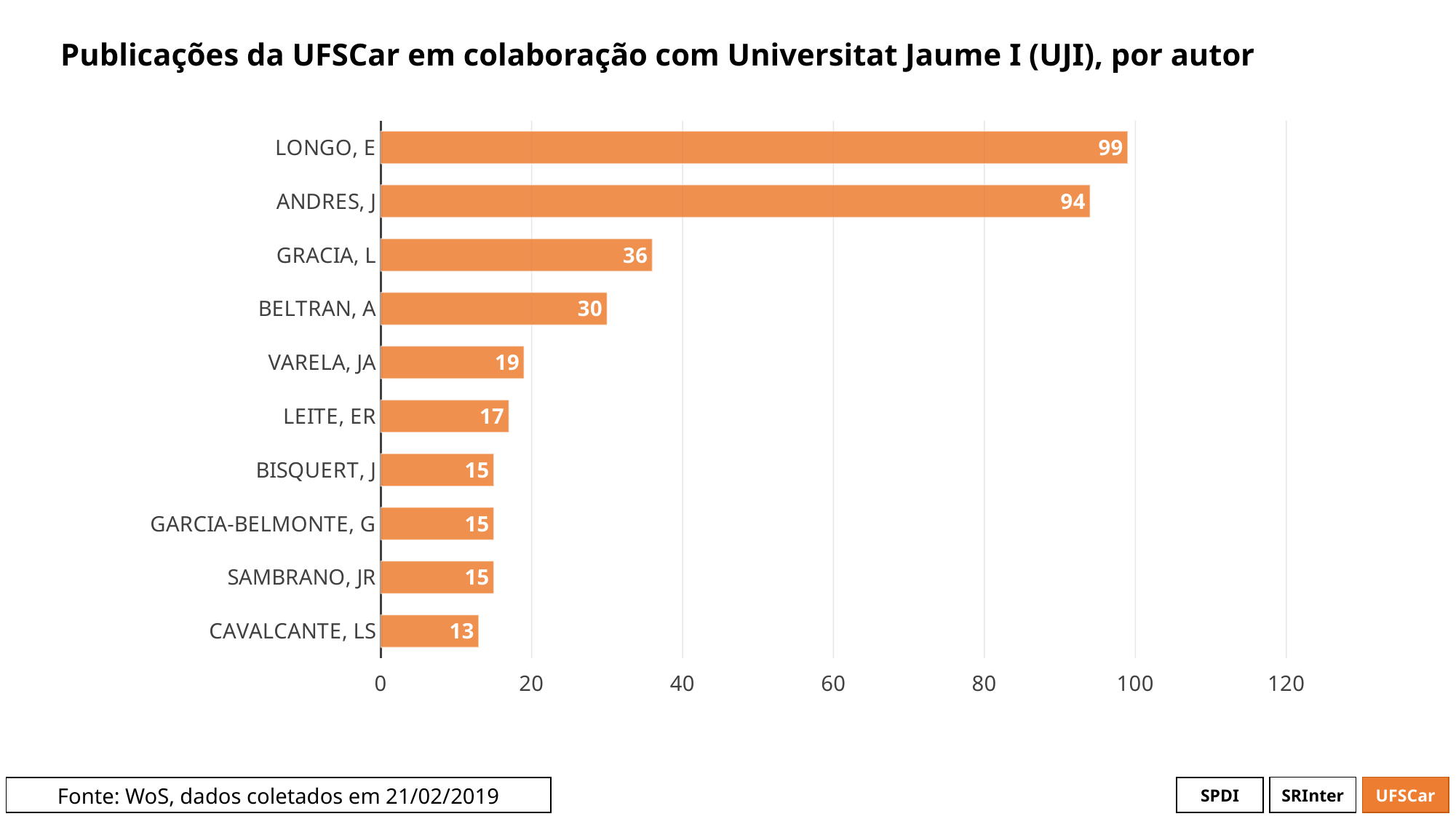
What is the value for GRACIA, L? 36 What is the title of the chart? Publicações da UFSCar em colaboração com Universitat Jaume I (UJI), por autor Which author has the lowest number of publications? CAVALCANTE, LS What is the value for CAVALCANTE, LS? 13 How many authors are shown in the chart? 10 What kind of chart is shown on the slide? bar chart What is the difference between the values for GRACIA, L and BELTRAN, A? 6 Which author has the highest number of publications? LONGO, E How many publications does LONGO, E have? 99 What is the difference between the values for LONGO, E and ANDRES, J? 5 Which is larger, the value for VARELA, JA or the value for LEITE, ER? VARELA, JA Is the value for ANDRES, J greater or less than 80? greater